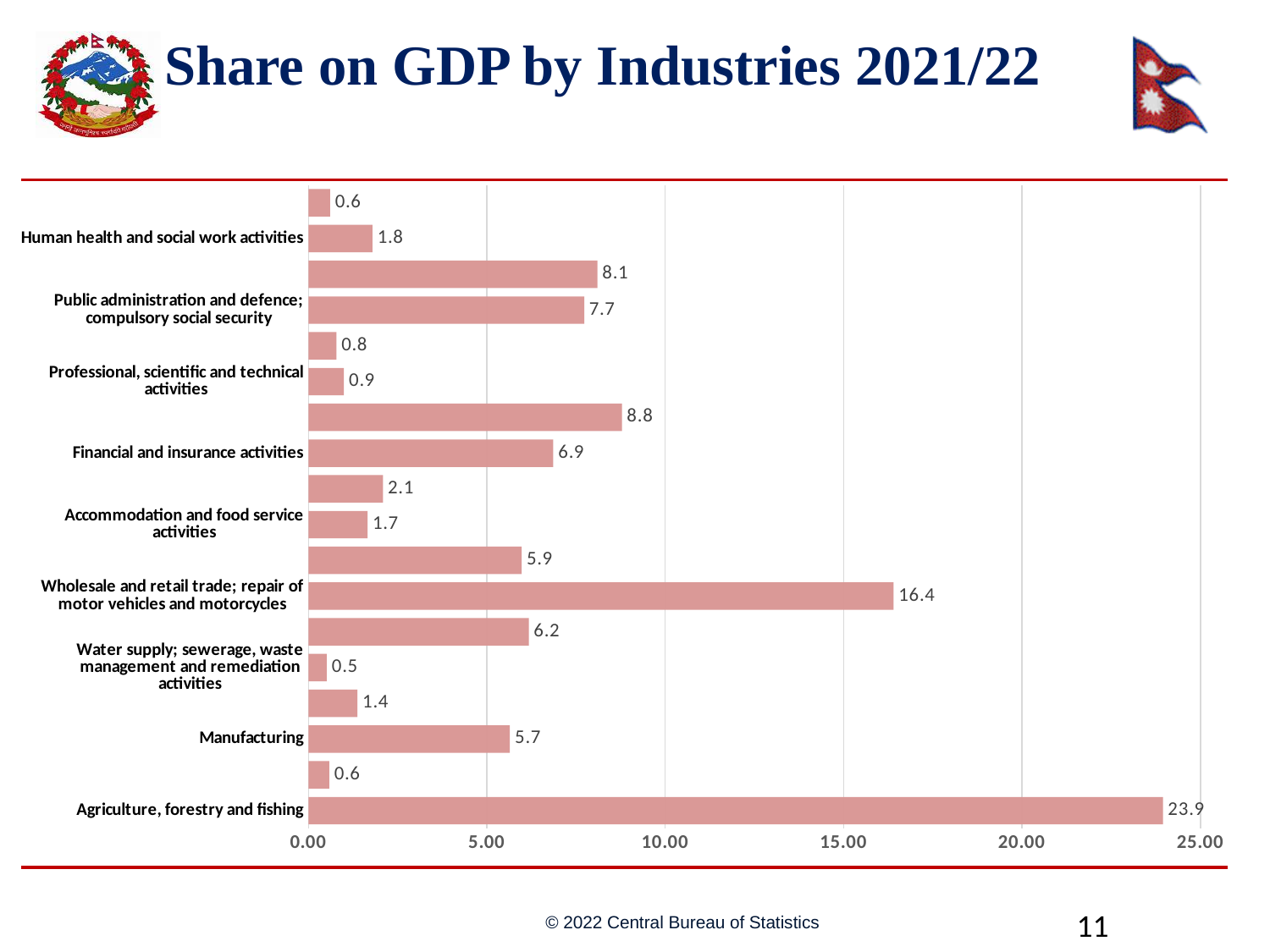
Which industry has the highest share on GDP? Agriculture, forestry and fishing Which is larger, the value for Manufacturing or the value for Financial and insurance activities? Financial and insurance activities What is the value shown for Financial and insurance activities? 6.9 Which labelled industry has the lowest share on GDP? Water supply; sewerage, waste management and remediation activities What is the difference between the values for Agriculture, forestry and fishing and Wholesale and retail trade; repair of motor vehicles and motorcycles? 7.5 Is the value for Wholesale and retail trade; repair of motor vehicles and motorcycles greater or less than 15.00? greater What is the share on GDP for Agriculture, forestry and fishing? 23.9 What is the value shown for Public administration and defence; compulsory social security? 7.7 What is the value shown for Wholesale and retail trade; repair of motor vehicles and motorcycles? 16.4 What is the value shown for Manufacturing? 5.7 What type of chart is shown on the slide? Bar chart How many bars are plotted in the chart? 18